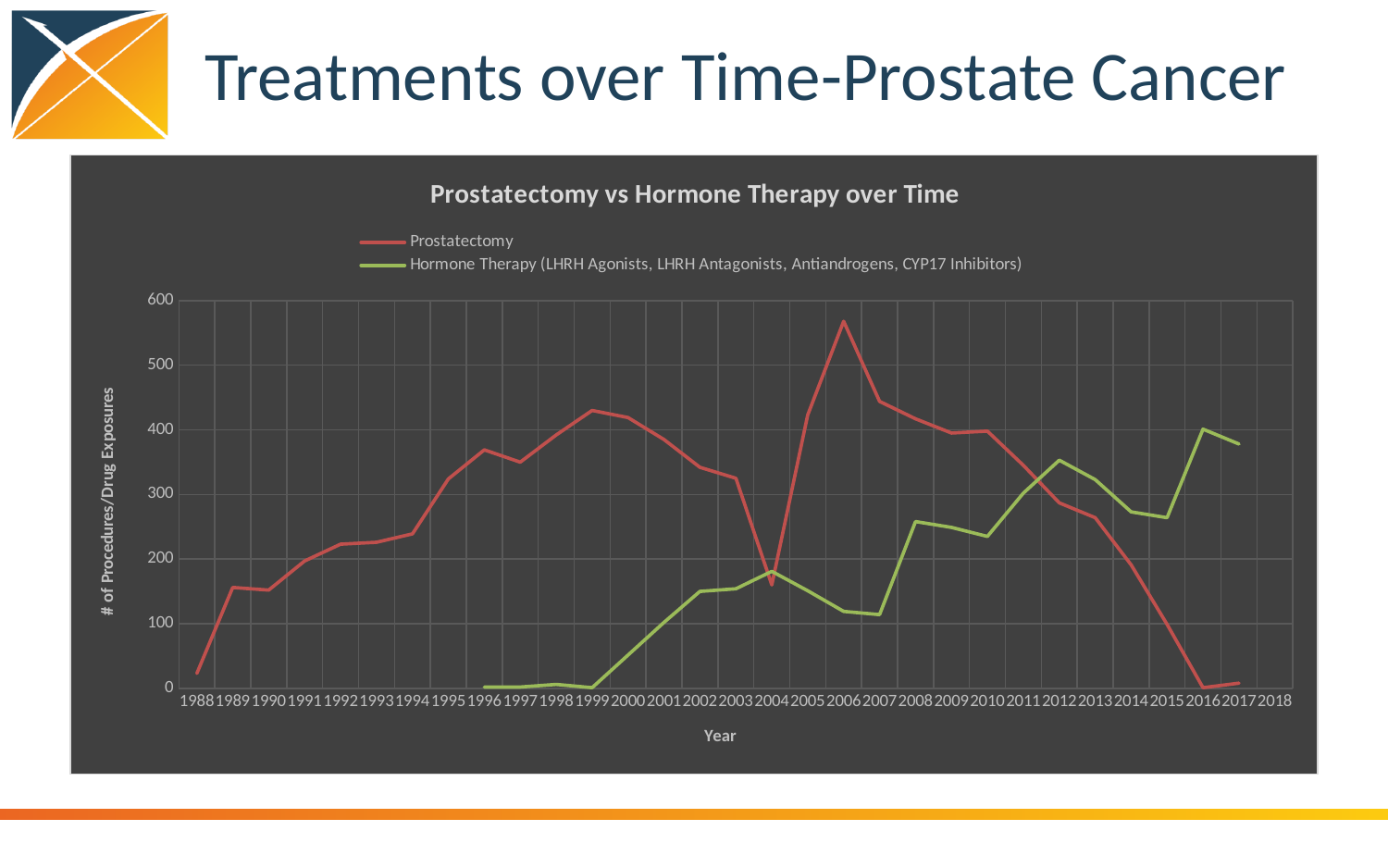
How many series does the legend list? 2 Is the Hormone Therapy value for 2007 greater or less than 200? less Is the Hormone Therapy value for 2012 greater or less than 300? greater In which year does the Hormone Therapy series reach its highest value? 2016 In 2016, which series has the higher value, Prostatectomy or Hormone Therapy? Hormone Therapy Is the Prostatectomy value for 1988 greater or less than 100? less Does the Prostatectomy series rise or fall from 2010 to 2016? fall What type of chart is shown on the slide? line chart What is the title of the chart? Prostatectomy vs Hormone Therapy over Time In which year does the Prostatectomy series reach its highest value? 2006 In 2010, which series has the higher value, Prostatectomy or Hormone Therapy? Prostatectomy